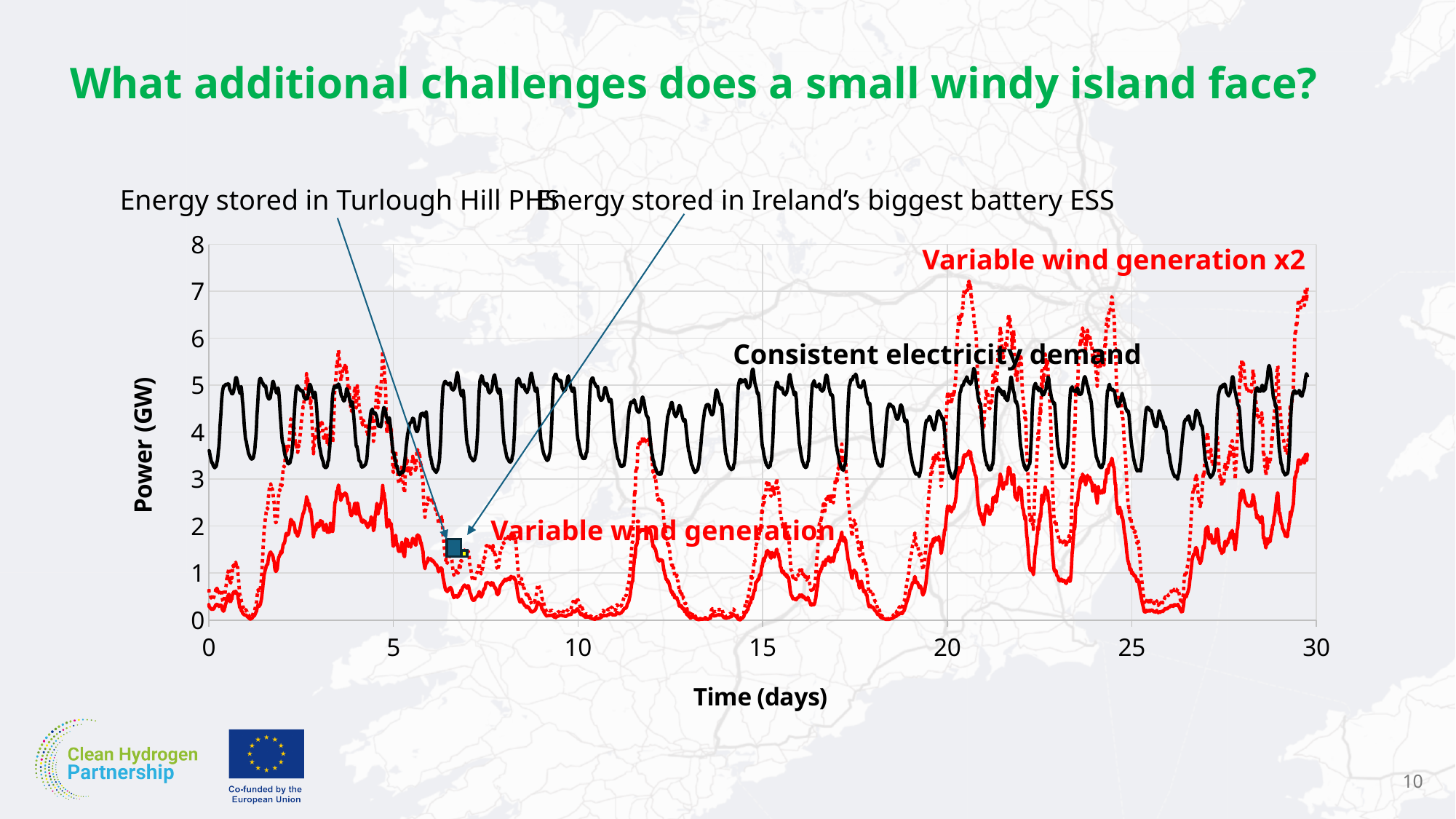
Is the lowest value of the Consistent electricity demand series greater or less than 2? greater Which series has the lower values around day 14: Variable wind generation or Consistent electricity demand? Variable wind generation Is the highest value reached by the Variable wind generation x2 series greater or less than 6? greater How many data series are plotted on the chart? 3 What is the maximum value shown on the horizontal axis? 30 Which series reaches a higher peak value: Variable wind generation x2 or Consistent electricity demand? Variable wind generation x2 What is the maximum value shown on the vertical axis? 8 Is the highest value reached by the Variable wind generation series greater or less than 5? less What is the title of the horizontal axis of the chart? Time (days) What kind of chart is shown on the slide? Line chart What is the title of the vertical axis of the chart? Power (GW)